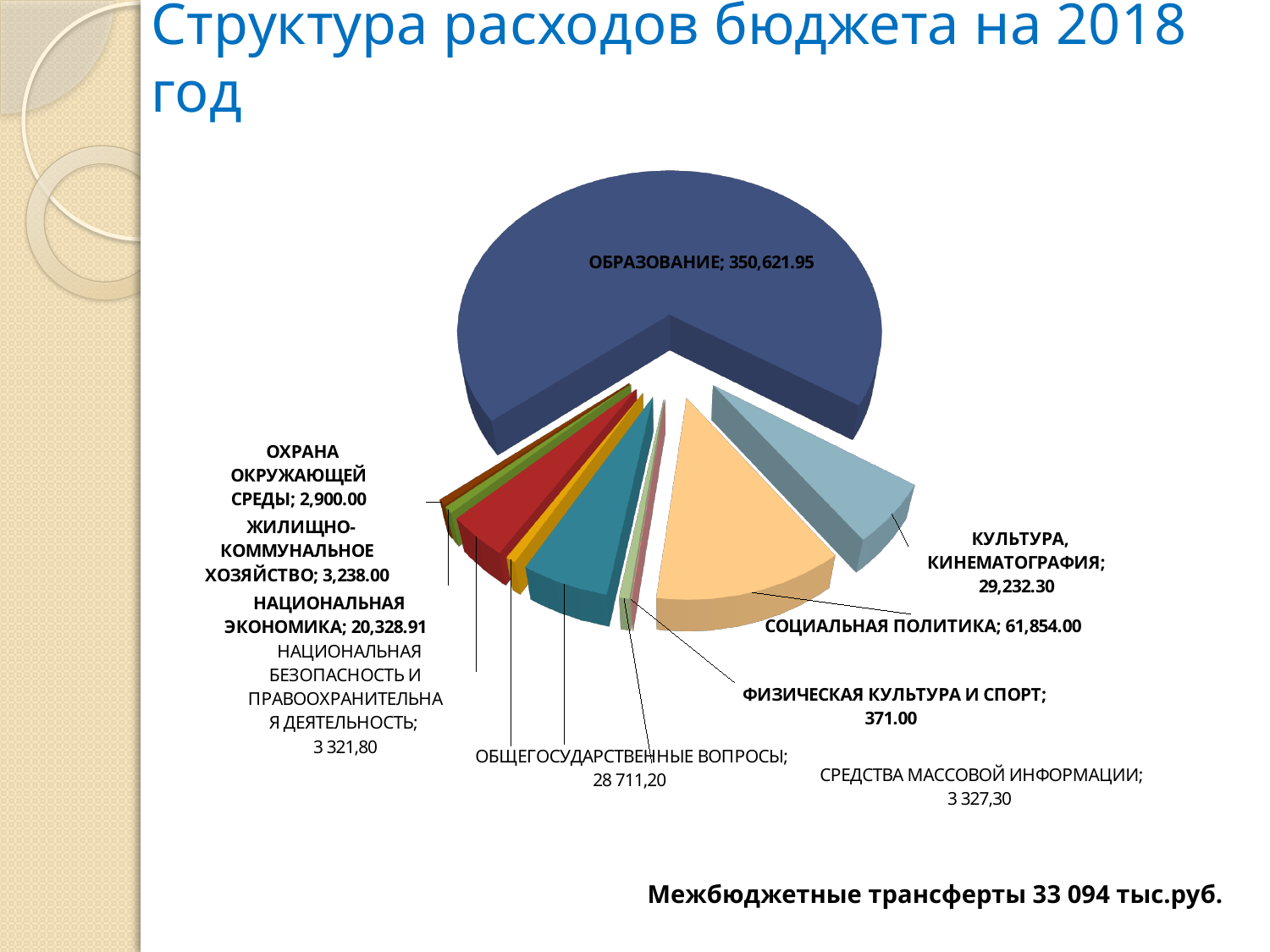
What is the value shown for КУЛЬТУРА, КИНЕМАТОГРАФИЯ? 29,232.30 What is the value shown for СОЦИАЛЬНАЯ ПОЛИТИКА? 61,854.00 What is the value shown for ОБЩЕГОСУДАРСТВЕННЫЕ ВОПРОСЫ? 28 711,20 Which is larger: the value for НАЦИОНАЛЬНАЯ ЭКОНОМИКА or the value for СОЦИАЛЬНАЯ ПОЛИТИКА? СОЦИАЛЬНАЯ ПОЛИТИКА How many categories (slices) does the pie chart show? 10 Which category has the smallest value in the pie chart? ФИЗИЧЕСКАЯ КУЛЬТУРА И СПОРТ What is the title of the slide containing the chart? Структура расходов бюджета на 2018 год What is the value shown for ОБРАЗОВАНИЕ? 350,621.95 What is the difference between the values for СОЦИАЛЬНАЯ ПОЛИТИКА and КУЛЬТУРА, КИНЕМАТОГРАФИЯ? 32,621.70 What kind of chart is shown on the slide? Pie chart Which category has the largest slice in the pie chart? ОБРАЗОВАНИЕ What is the value shown for ОХРАНА ОКРУЖАЮЩЕЙ СРЕДЫ? 2,900.00